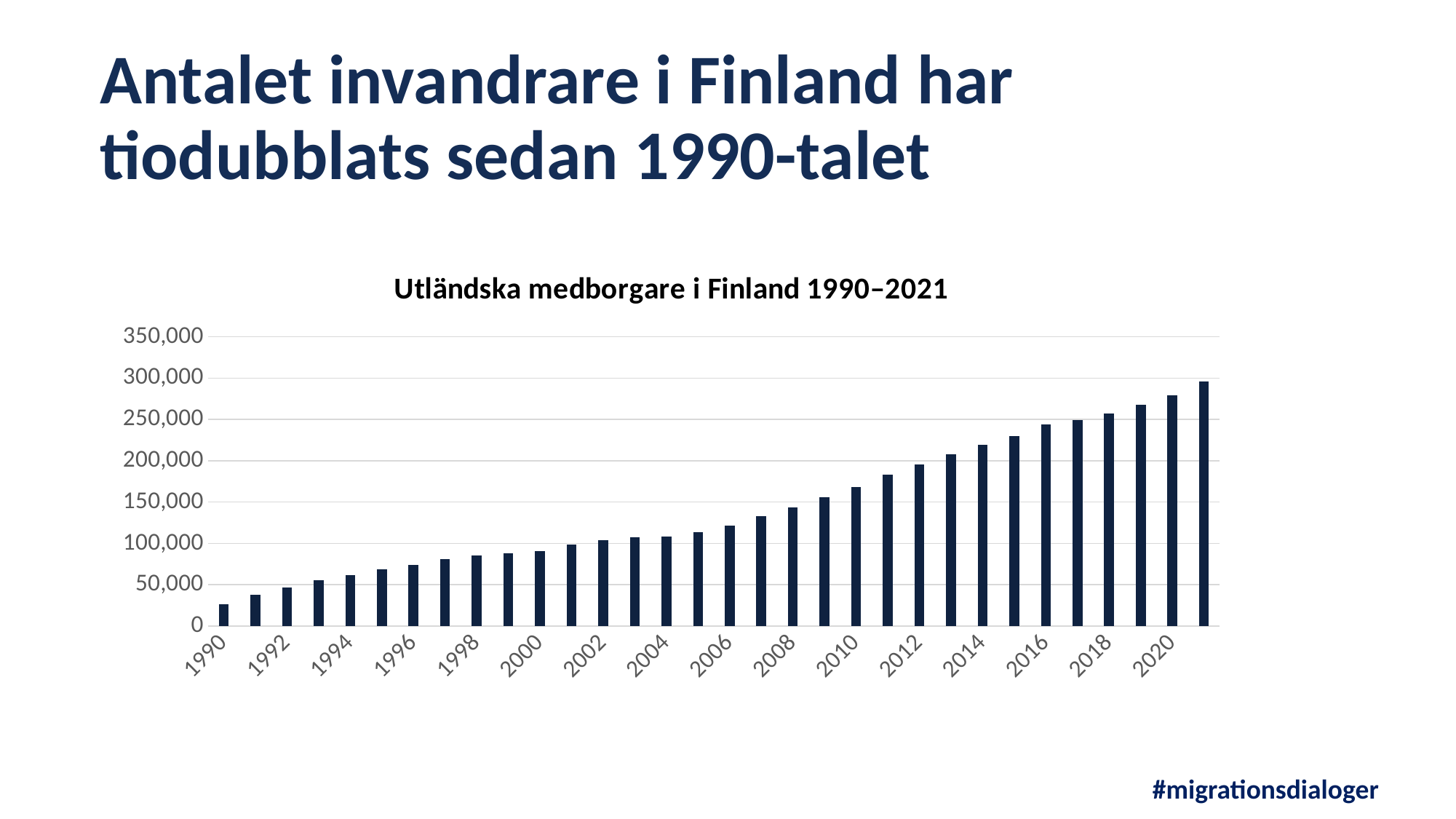
Is the value for 2020 greater or less than 250,000? greater How many bars (years) are plotted in the chart? 32 Is the value for 2014 greater or less than 200,000? greater Is the value for 1996 greater or less than 50,000? greater Which year has the larger value, 2000 or 2010? 2010 What kind of chart is shown on the slide? bar chart Which year has the lowest value in the chart? 1990 What is the title of the chart? Utländska medborgare i Finland 1990–2021 Which year has the highest value in the chart? 2021 Do the values rise or fall from 1990 to 2021? rise